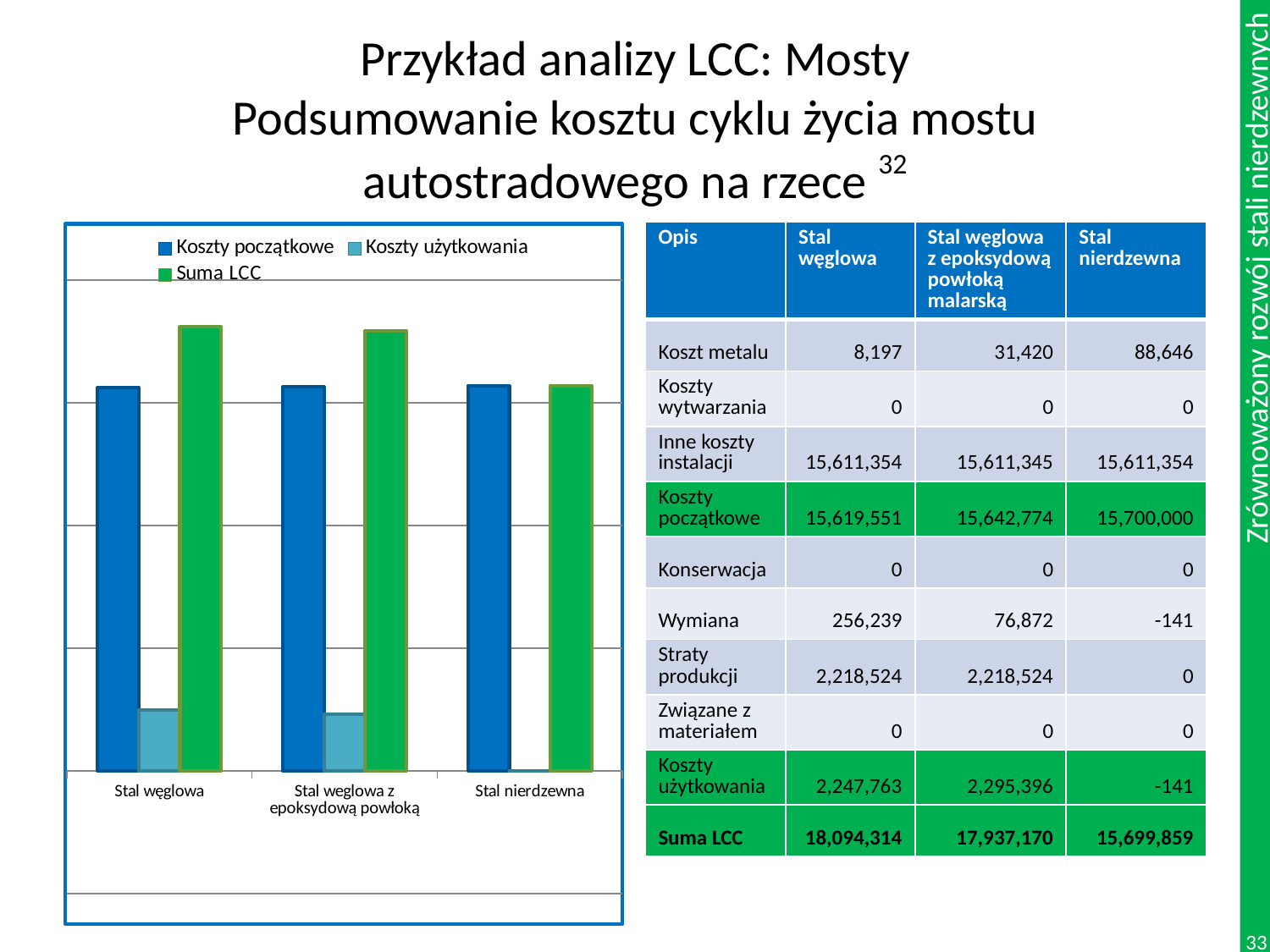
How many categories are shown on the x axis of the chart? 3 Where is the legend positioned in the chart? at the top Do the Suma LCC bars rise or fall from left to right across the categories? fall Which series in the chart is drawn in green? Suma LCC Do the Koszty użytkowania bars rise or fall from left to right across the categories? fall Which is larger in the chart: Koszty użytkowania for Stal węglowa or Koszty użytkowania for Stal nierdzewna? Stal węglowa How many series does the chart legend list? 3 For Stal węglowa, which bar is taller: Koszty początkowe or Suma LCC? Suma LCC Which category has the lowest Koszty użytkowania bar in the chart? Stal nierdzewna Which category has the lowest Suma LCC bar in the chart? Stal nierdzewna What kind of chart is shown on the slide? bar chart